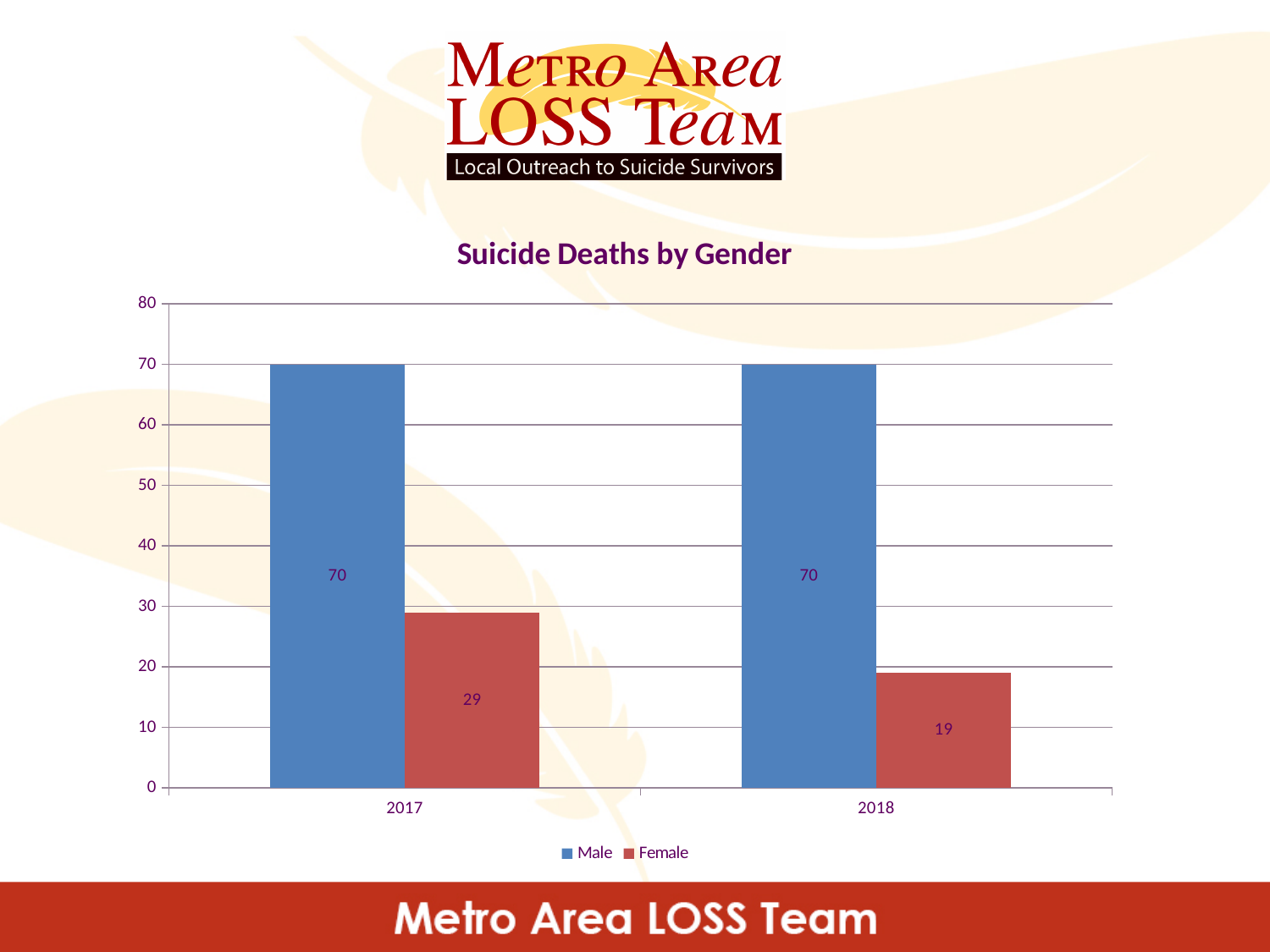
Which is larger in 2018, the Male value or the Female value? Male Which year has the lowest Female value? 2018 What is the value for Female in 2018? 19 Is the Female value for 2017 greater or less than 20? greater What is the value for Male in 2017? 70 How many series does the legend list? 2 What is the difference between the Female values for 2017 and 2018? 10 What kind of chart is shown? Bar chart How many years are shown on the x axis? 2 What is the value for Female in 2017? 29 What is the difference between the Male and Female values in 2017? 41 What is the title of the chart? Suicide Deaths by Gender